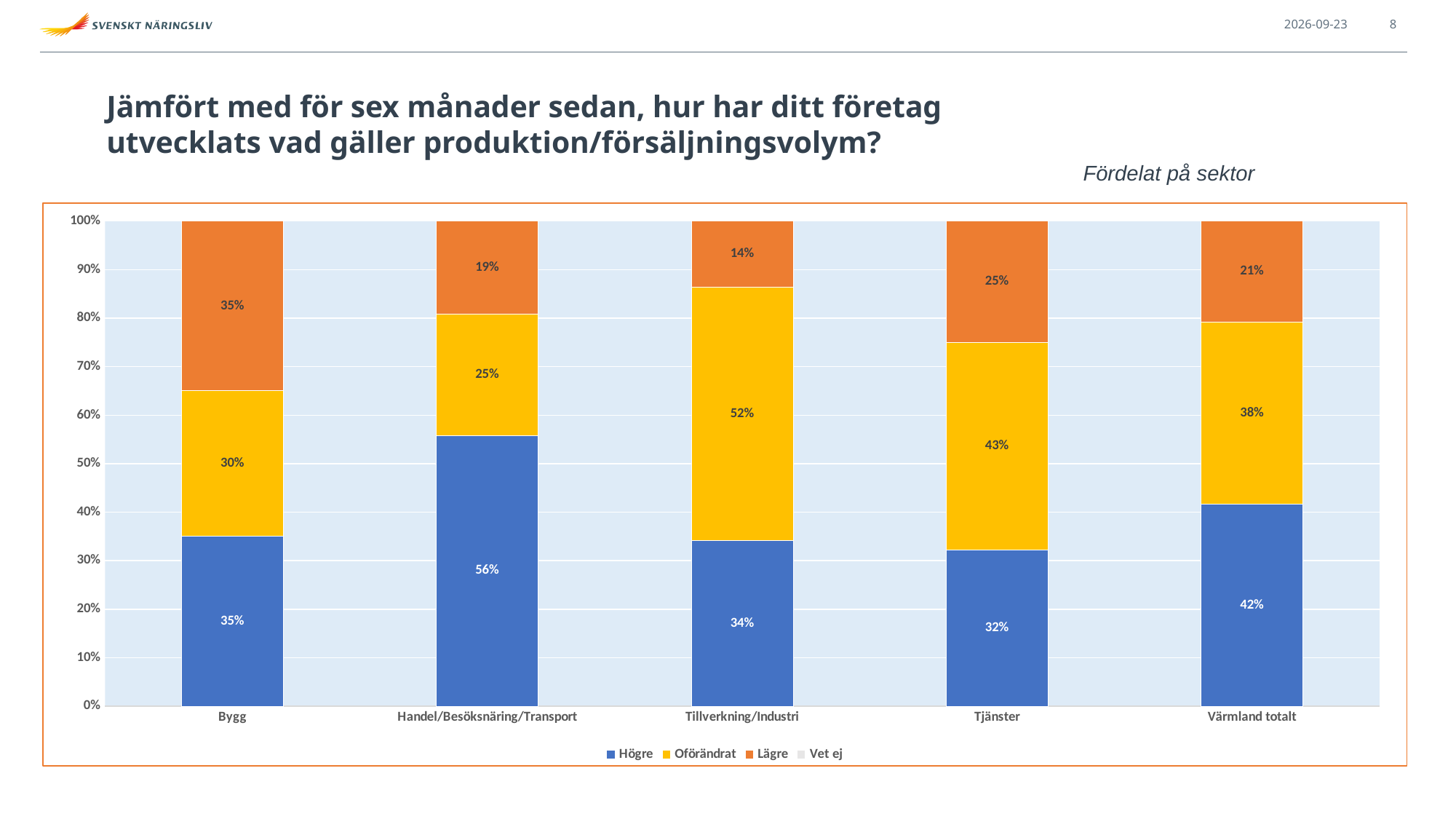
Which is larger, the Lägre value for Tjänster or the Lägre value for Handel/Besöksnäring/Transport? Tjänster How many series does the legend list? 4 How many categories are shown on the x axis? 5 Which category has the lowest Lägre value? Tillverkning/Industri What is the Högre value for Handel/Besöksnäring/Transport? 56% What is the Oförändrat value for Tillverkning/Industri? 52% Which series is shown in blue in the legend? Högre What kind of chart is shown on the slide? Stacked bar chart Which category has the highest Högre value? Handel/Besöksnäring/Transport What is the Högre value for Värmland totalt? 42% What is the Lägre value for Bygg? 35% What is the difference between the Oförändrat values for Tjänster and Bygg? 13%